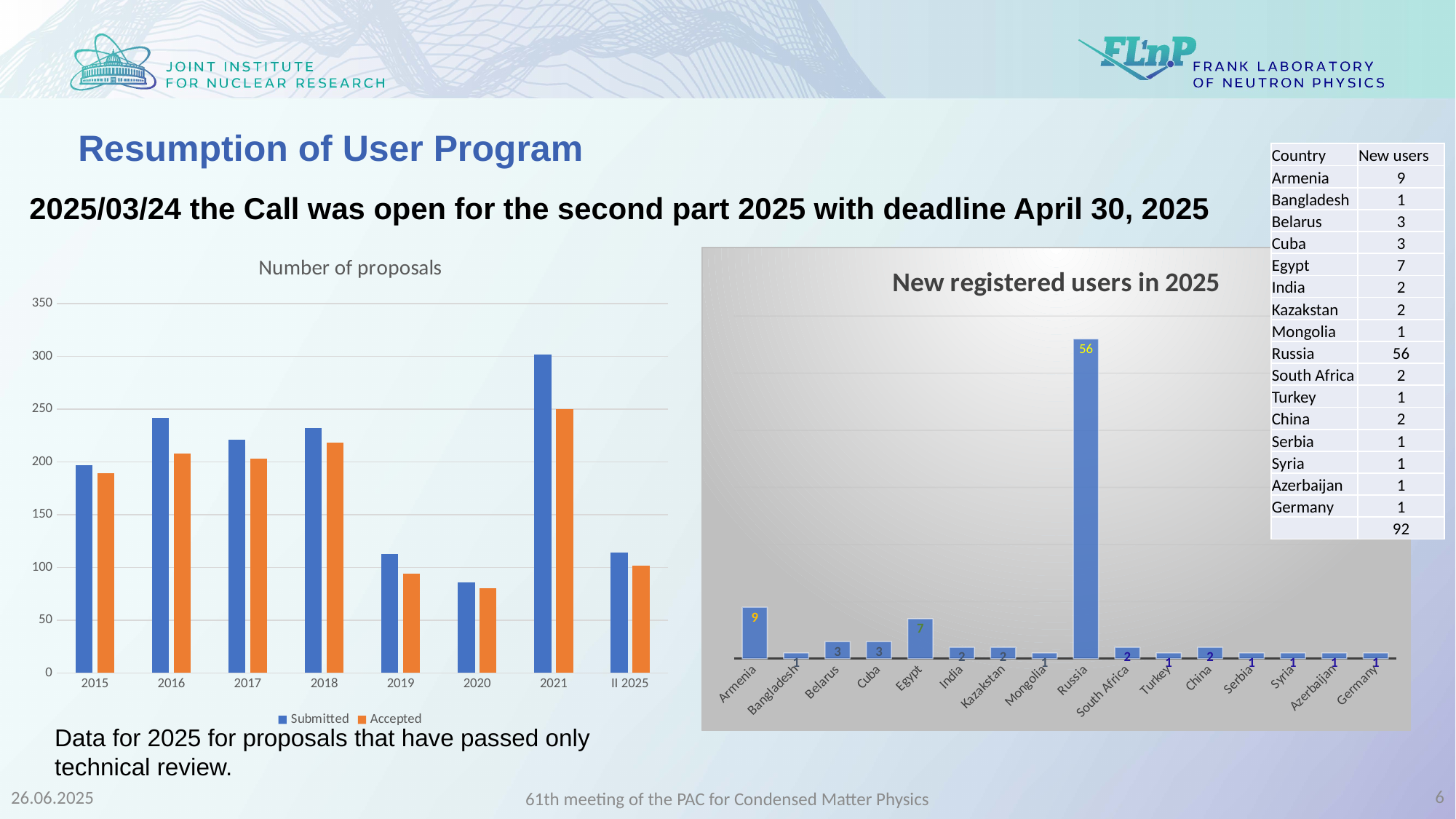
In the 'Number of proposals' chart, what kind of chart is it? bar chart In the 'Number of proposals' chart, is the Submitted value for 2019 greater or less than 100? greater In the 'Number of proposals' chart, which year has the highest number of submitted proposals? 2021 In the 'Number of proposals' chart, which year has the lowest number of submitted proposals? 2020 In the 'New registered users in 2025' chart, how many countries are shown? 16 In the 'Number of proposals' chart, how many categories are shown on the x axis? 8 In the 'Number of proposals' chart, which is larger: Submitted in 2016 or Submitted in 2017? Submitted in 2016 In the 'Number of proposals' chart, how many series does the legend list? 2 In the 'New registered users in 2025' chart, what is the difference between Russia and Egypt? 49 In the 'New registered users in 2025' chart, what is the value for Armenia? 9 In the 'New registered users in 2025' chart, what is the value for Russia? 56 In the 'Number of proposals' chart, is the Accepted value for 2018 greater or less than 200? greater